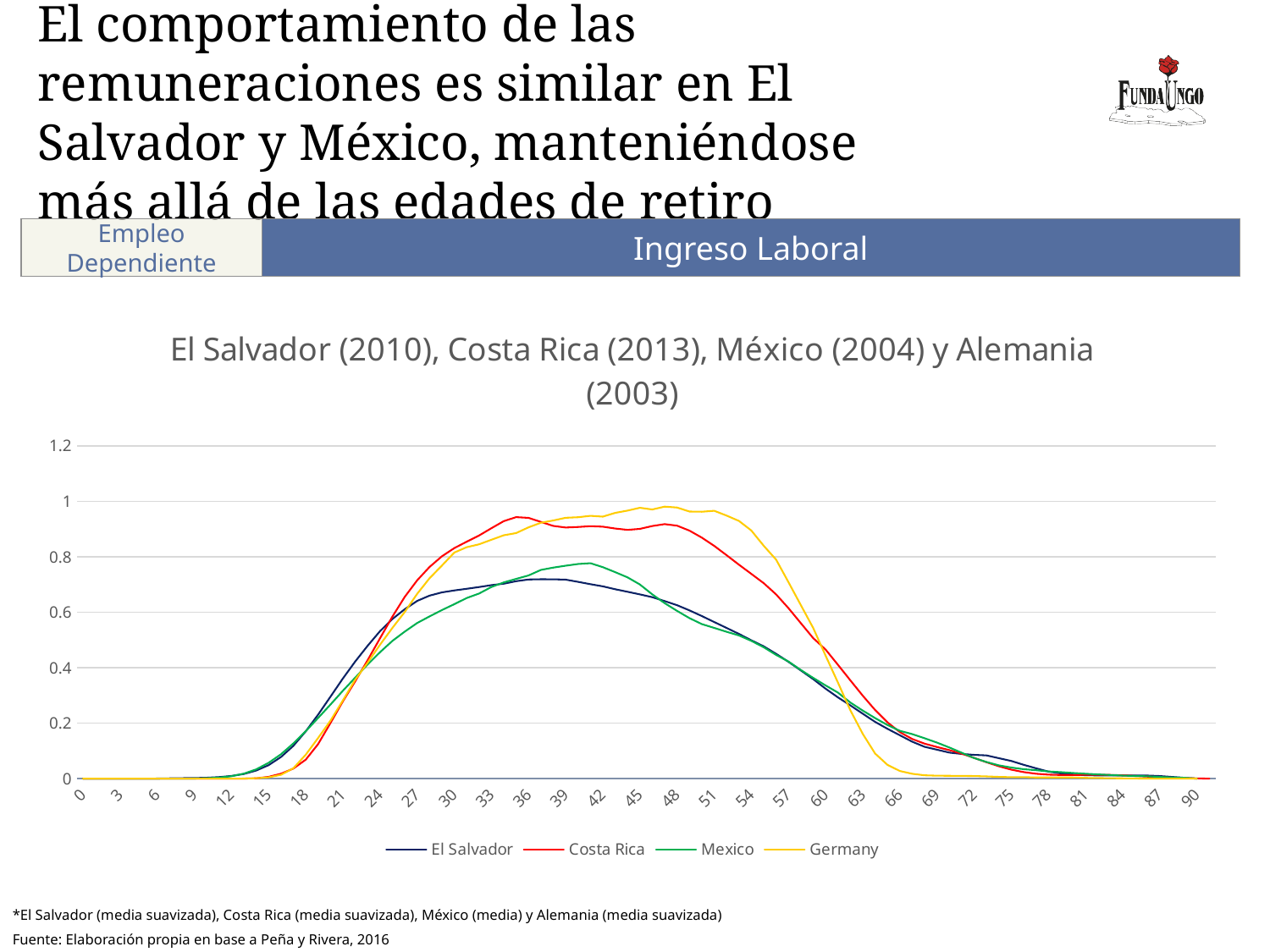
What kind of chart is shown on the slide? line chart Is the value for Mexico at age 39 greater or less than 0.6? greater Which series are listed in the chart's legend? El Salvador, Costa Rica, Mexico, Germany At age 72, which series has the higher value, El Salvador or Germany? El Salvador Is the value for El Salvador at age 36 greater or less than 0.6? greater Is the value for Germany at age 66 greater or less than 0.2? less Between ages 51 and 66, does the Germany line rise or fall? fall Between ages 15 and 30, does the Costa Rica line rise or fall? rise At age 45, which series has the higher value, Germany or Mexico? Germany How many series does the chart's legend list? 4 What is the title of the chart? El Salvador (2010), Costa Rica (2013), México (2004) y Alemania (2003)